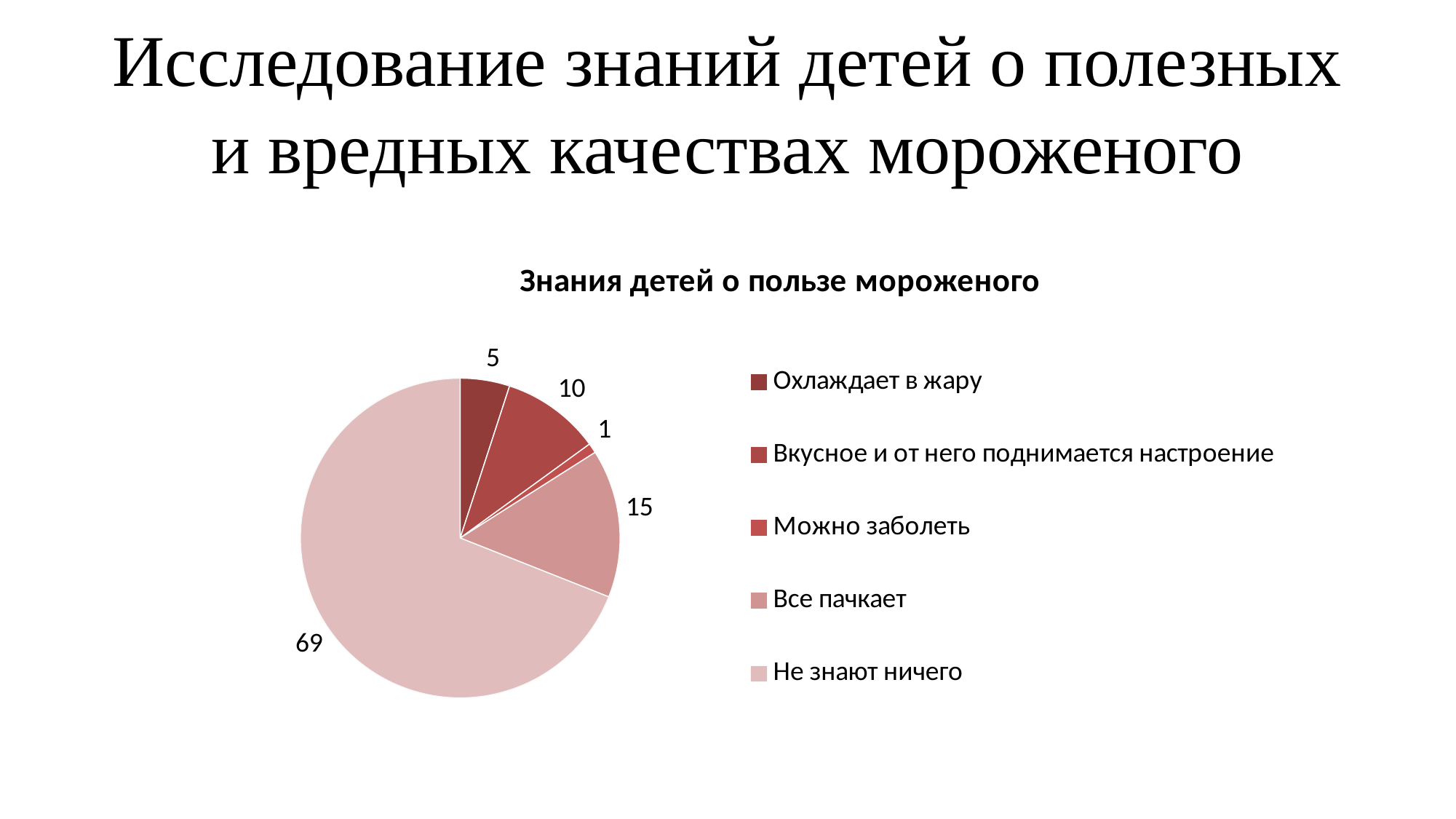
What is the value for "Вкусное и от него поднимается настроение"? 10 What is the title of the chart? Знания детей о пользе мороженого What is the value for "Можно заболеть"? 1 Which category has the largest slice? Не знают ничего What is the value for "Не знают ничего"? 69 What is the difference between the values for "Все пачкает" and "Охлаждает в жару"? 10 How many categories does the pie chart have? 5 What is the value for "Охлаждает в жару"? 5 What is the value for "Все пачкает"? 15 What type of chart is shown on the slide? Pie chart Which category has the smallest slice? Можно заболеть Which is larger: the value for "Вкусное и от него поднимается настроение" or the value for "Все пачкает"? Все пачкает